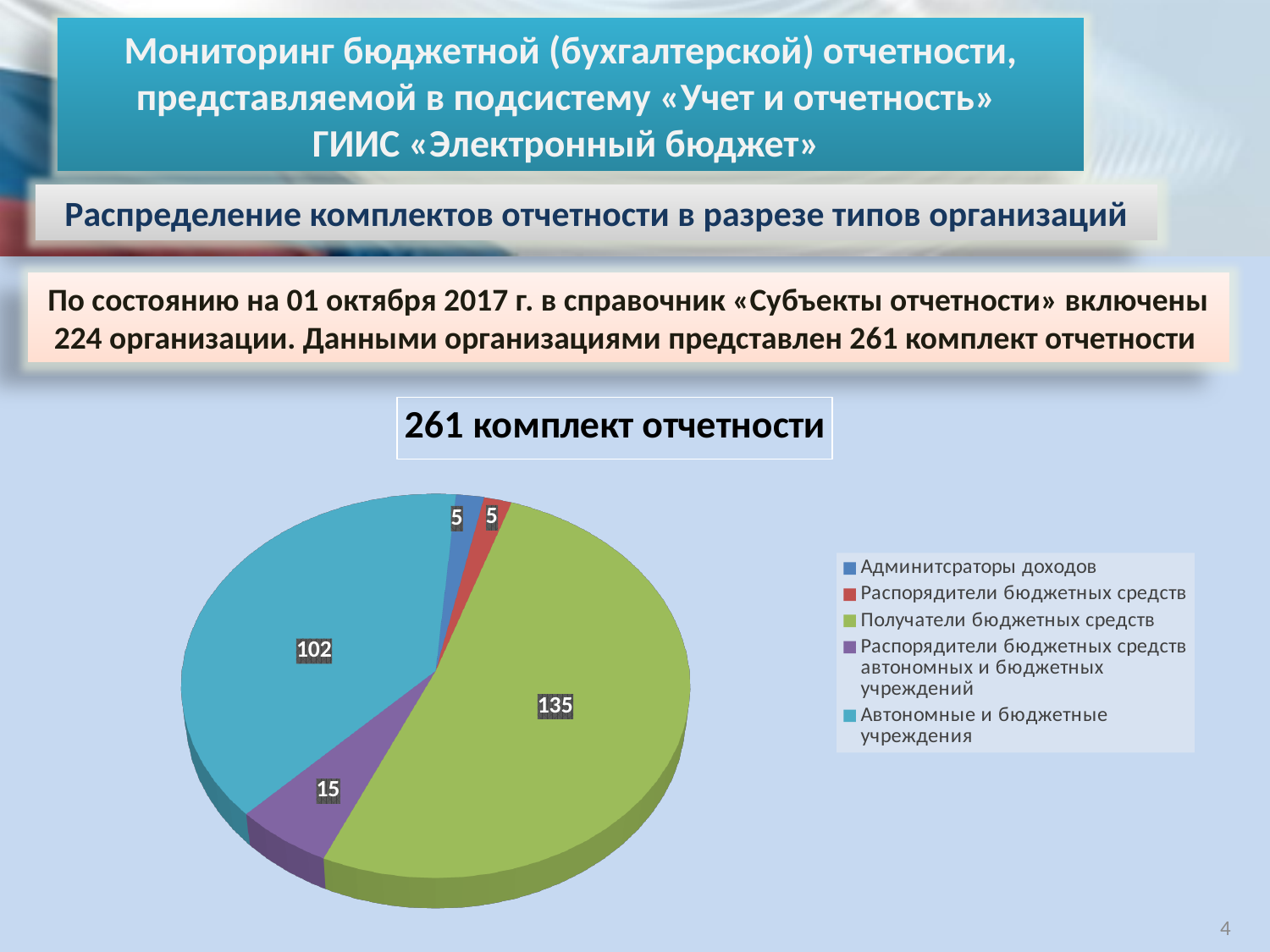
What is the difference between the values for Получатели бюджетных средств and Автономные и бюджетные учреждения? 33 What is the difference between the values for Автономные и бюджетные учреждения and Распорядители бюджетных средств автономных и бюджетных учреждений? 87 What is the title shown above the pie chart? 261 комплект отчетности What is the smallest value shown in the pie chart? 5 What is the value for Администраторы доходов in the pie chart? 5 How many slices does the pie chart have? 5 What is the value for Распорядители бюджетных средств автономных и бюджетных учреждений in the pie chart? 15 Which category has the largest slice in the pie chart? Получатели бюджетных средств What is the value for Получатели бюджетных средств in the pie chart? 135 Which is larger: the value for Автономные и бюджетные учреждения or the value for Распорядители бюджетных средств автономных и бюджетных учреждений? Автономные и бюджетные учреждения What is the value for Автономные и бюджетные учреждения in the pie chart? 102 What type of chart is shown on the slide? pie chart